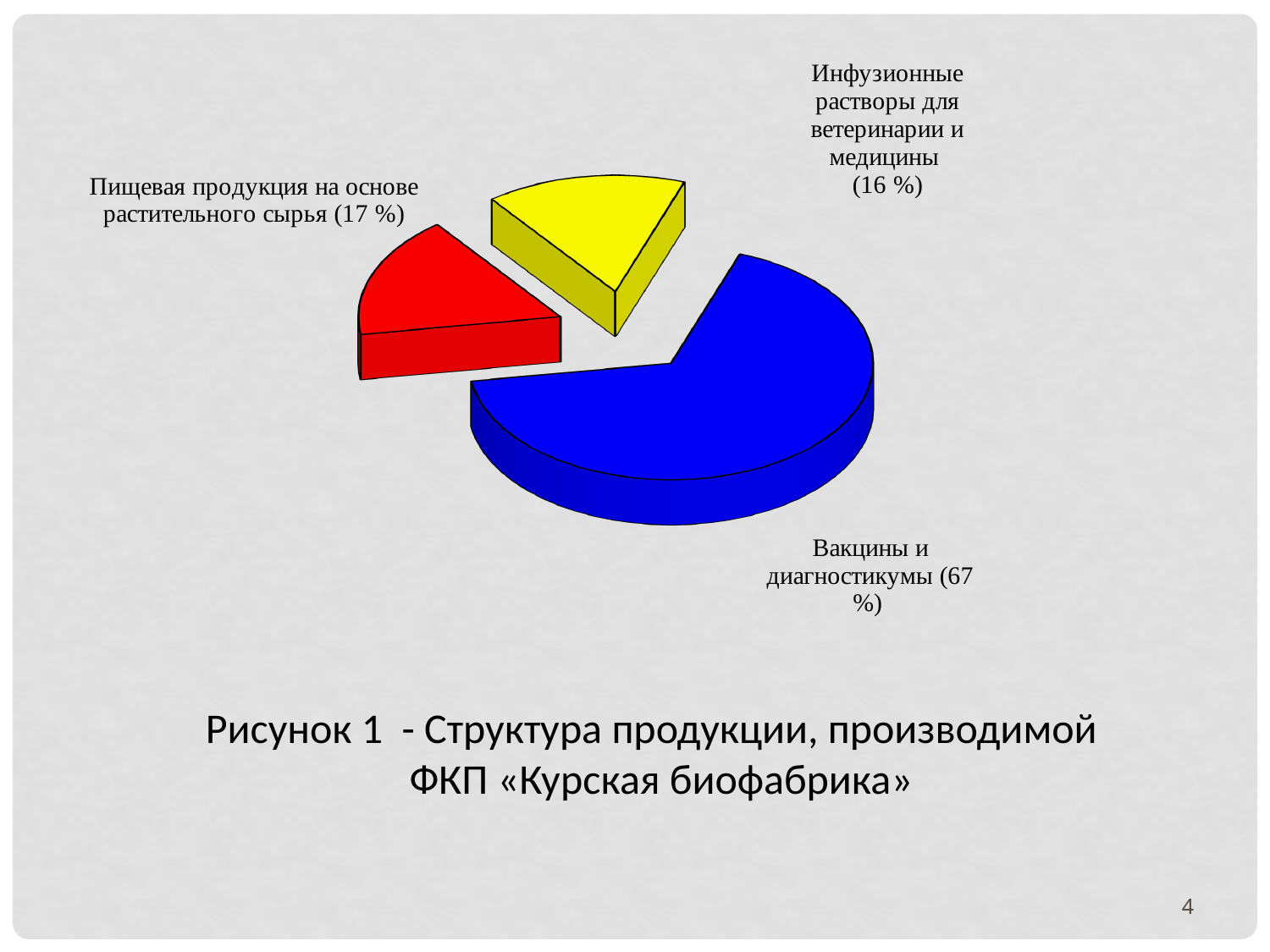
What kind of chart is shown on the slide? pie chart How many slices does the pie chart have? 3 What share of production is Инфузионные растворы для ветеринарии и медицины? 16 % Which product category has the largest share of the pie? Вакцины и диагностикумы What share of production is Пищевая продукция на основе растительного сырья? 17 % What colour is the slice for Вакцины и диагностикумы? blue Which product category has the smallest share of the pie? Инфузионные растворы для ветеринарии и медицины What is the caption (figure title) of the chart? Рисунок 1 - Структура продукции, производимой ФКП «Курская биофабрика» Which has a larger share: Пищевая продукция на основе растительного сырья or Инфузионные растворы для ветеринарии и медицины? Пищевая продукция на основе растительного сырья What share of production is Вакцины и диагностикумы? 67 % What is the difference in percentage points between Вакцины и диагностикумы and Пищевая продукция на основе растительного сырья? 50 What is the difference in percentage points between Пищевая продукция на основе растительного сырья and Инфузионные растворы для ветеринарии и медицины? 1